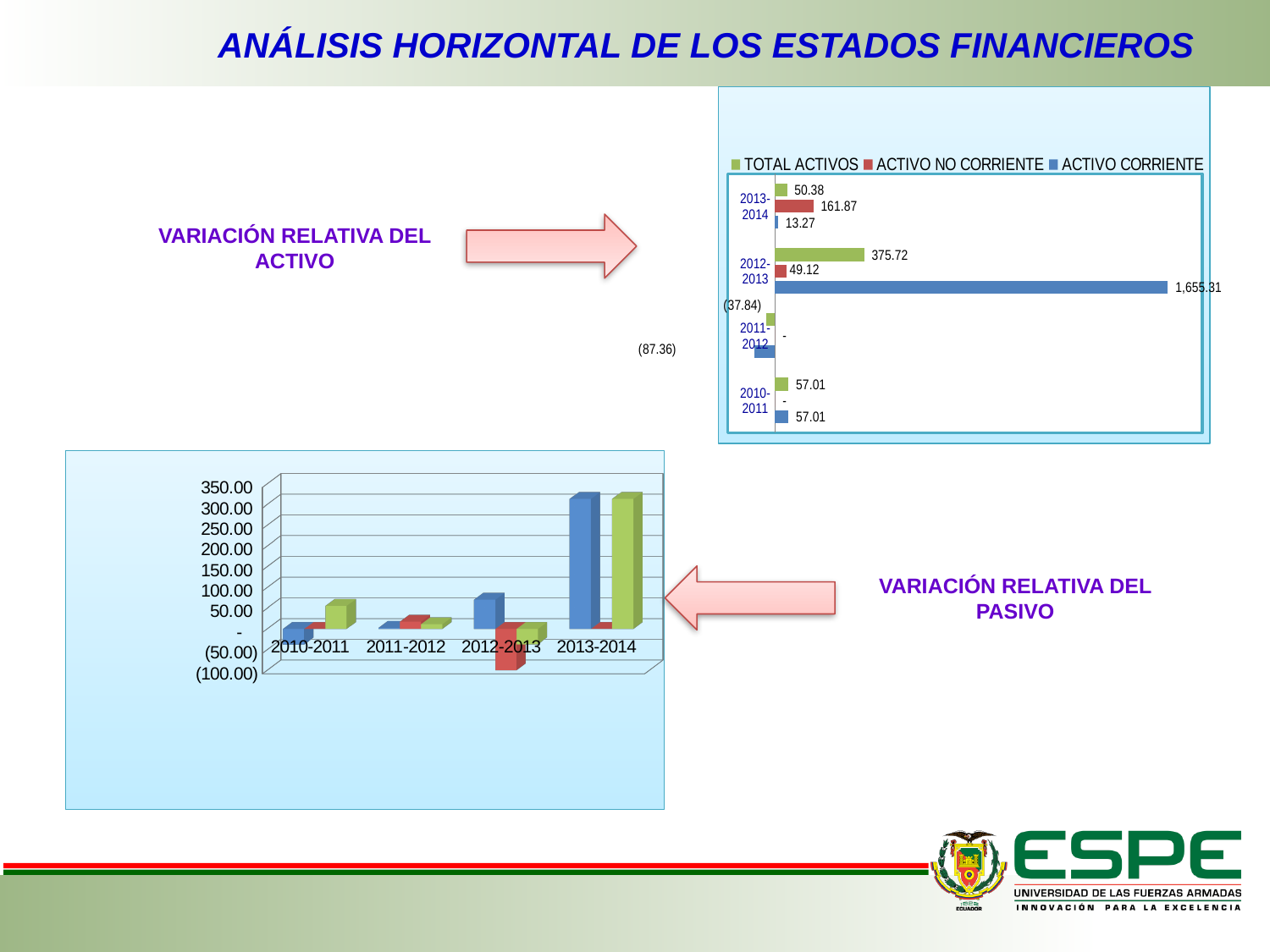
In the chart on the right (Variación relativa del activo), how many series does the legend list? 3 In the chart on the right (Variación relativa del activo), what is the value of ACTIVO CORRIENTE for 2010-2011? 57.01 In the chart on the right (Variación relativa del activo), what is the value of TOTAL ACTIVOS for 2011-2012? (37.84) In the chart at the bottom left (Variación relativa del pasivo), is the value of the blue bar for 2013-2014 greater or less than 200? greater In the chart on the right (Variación relativa del activo), which is larger for 2012-2013: TOTAL ACTIVOS or ACTIVO NO CORRIENTE? TOTAL ACTIVOS In the chart on the right (Variación relativa del activo), what is the value of ACTIVO CORRIENTE for 2012-2013? 1,655.31 In the chart on the right (Variación relativa del activo), what is the difference between ACTIVO NO CORRIENTE and ACTIVO CORRIENTE for 2013-2014? 148.60 What kind of chart is the one at the bottom left (Variación relativa del pasivo)? bar chart In the chart on the right (Variación relativa del activo), what is the value of TOTAL ACTIVOS for 2012-2013? 375.72 In the chart on the right (Variación relativa del activo), which period has the highest value for ACTIVO CORRIENTE? 2012-2013 In the chart on the right (Variación relativa del activo), what is the value of ACTIVO NO CORRIENTE for 2013-2014? 161.87 In the chart at the bottom left (Variación relativa del pasivo), how many periods are shown on the x axis? 4